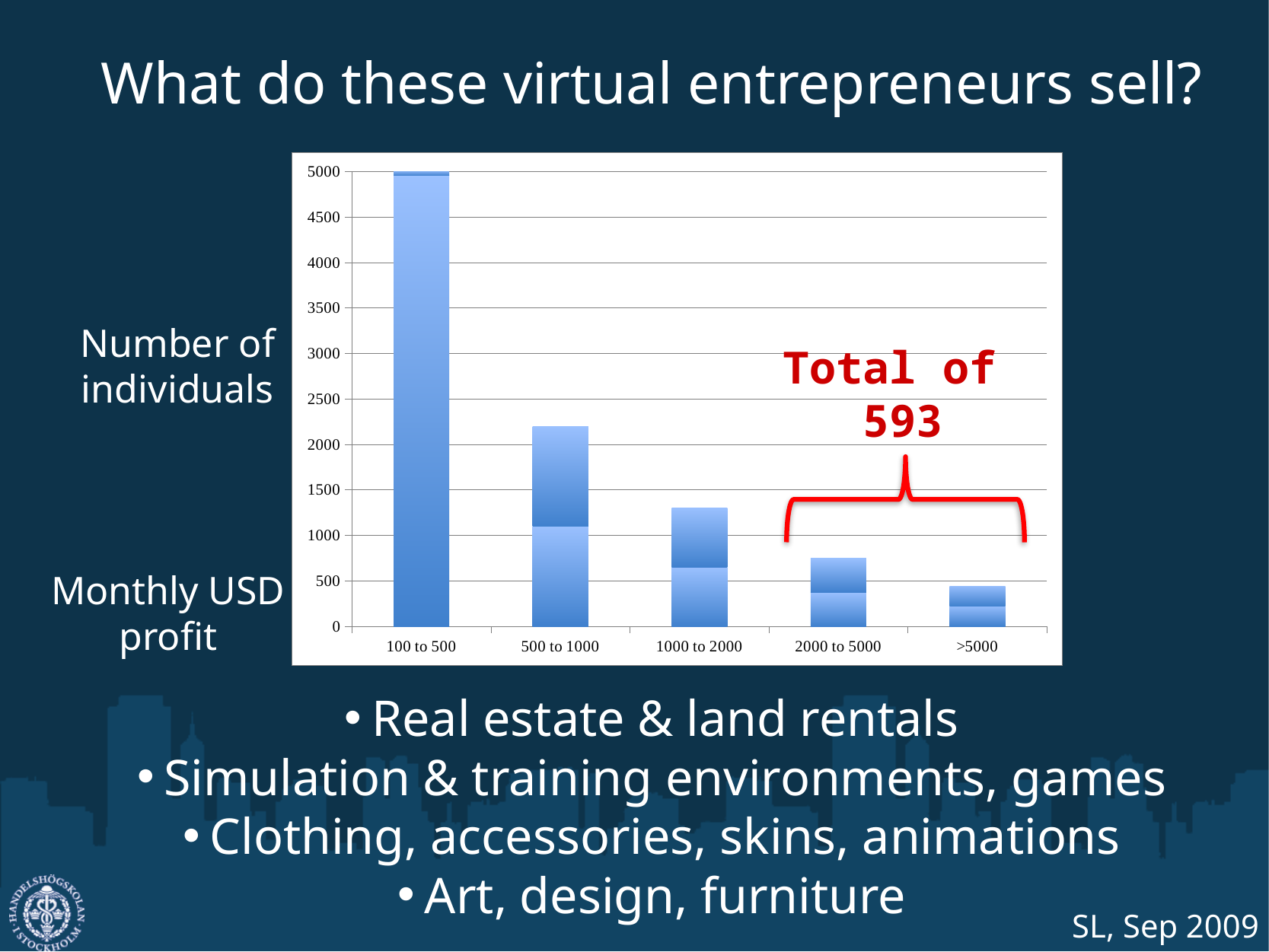
What kind of chart is shown on the slide? bar chart How many categories are shown on the x axis of the chart? 5 Do the values rise or fall moving from left to right along the x axis? fall What total does the red annotation give for the 2000 to 5000 and >5000 categories combined? 593 Is the value for the 1000 to 2000 category greater or less than 1500? less Is the value for the >5000 category greater or less than 500? less Is the value for the 500 to 1000 category greater or less than 2000? greater Which monthly USD profit category has the lowest number of individuals? >5000 Which category has more individuals, 500 to 1000 or 1000 to 2000? 500 to 1000 Which monthly USD profit category has the highest number of individuals? 100 to 500